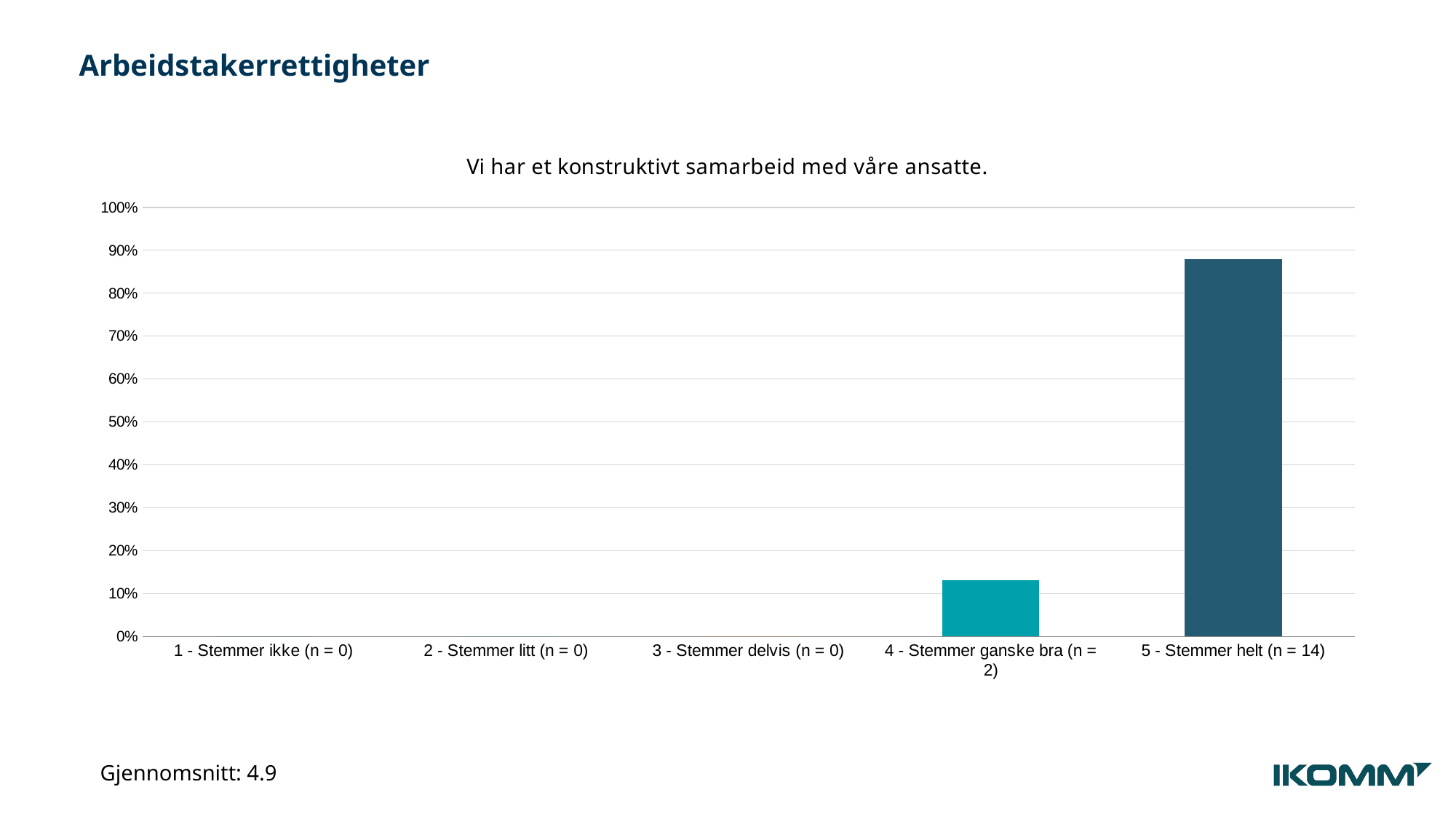
Is the value for "5 - Stemmer helt" greater or less than 80%? greater What is the value for "1 - Stemmer ikke"? 0% What is the Gjennomsnitt (average) shown on the slide? 4.9 Which is larger, the value for "4 - Stemmer ganske bra" or the value for "5 - Stemmer helt"? 5 - Stemmer helt What kind of chart is shown on the slide? Bar chart Is the value for "4 - Stemmer ganske bra" greater or less than 10%? greater Do the values generally rise or fall from left to right along the x axis? Rise Is the value for "4 - Stemmer ganske bra" greater or less than 20%? less How many categories are shown on the x axis of the chart? 5 Which category has the highest value in the chart? 5 - Stemmer helt (n = 14) What is the title of the chart? Vi har et konstruktivt samarbeid med våre ansatte.